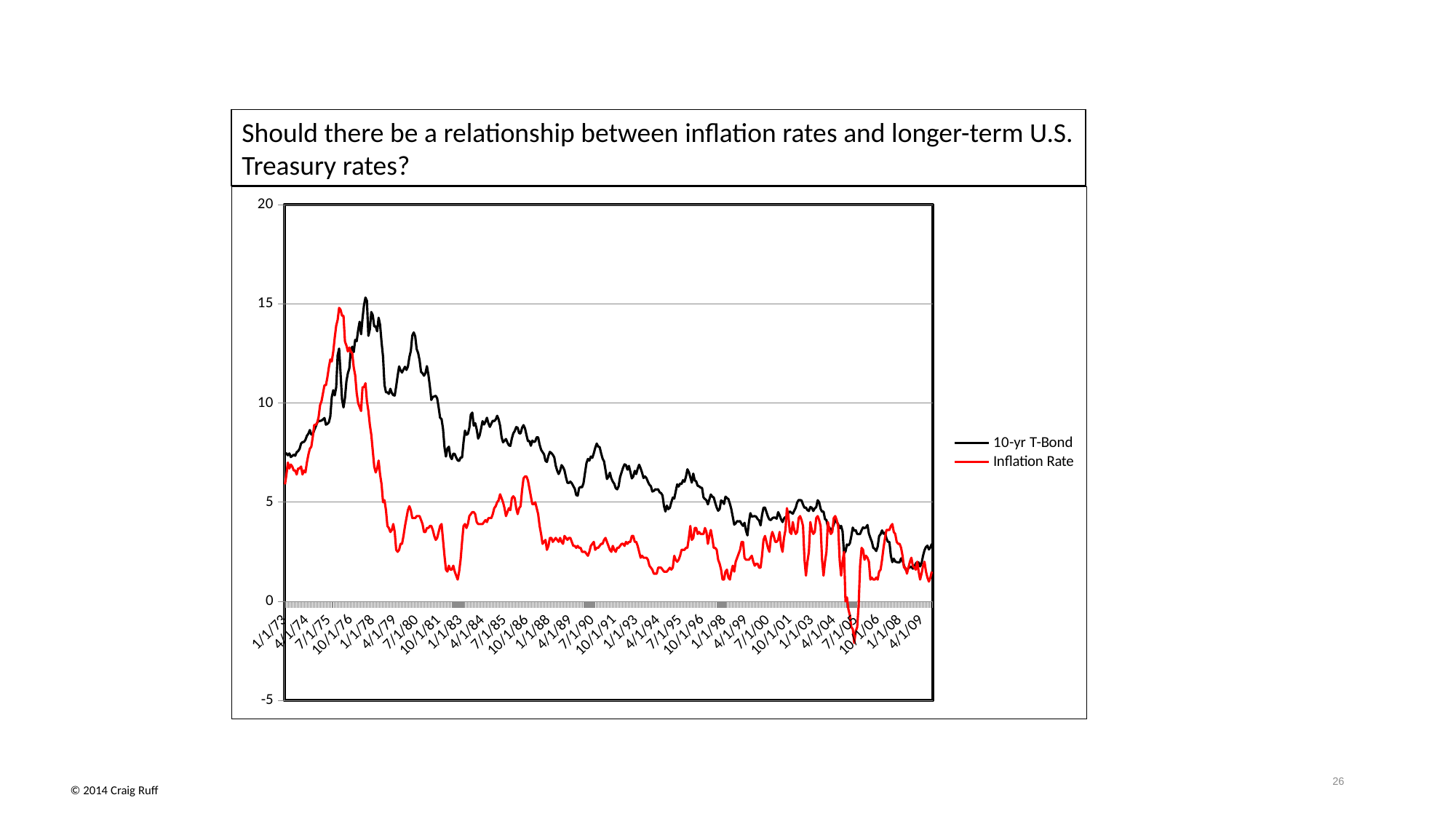
Which series is drawn in black? 10-yr T-Bond Which series is drawn in red? Inflation Rate Around 7/1/90, which series has the higher value, 10-yr T-Bond or Inflation Rate? 10-yr T-Bond What is the highest value shown on the vertical axis? 20 Is the 10-yr T-Bond value at 1/1/73 greater or less than 5? greater Is the Inflation Rate value at 1/1/83 greater or less than 5? less Is the 10-yr T-Bond value at 7/1/90 greater or less than 5? greater What kind of chart is shown on the slide? Line chart What is the lowest value shown on the vertical axis? -5 Does the 10-yr T-Bond series generally rise or fall from the early 1980s to 4/1/09? Fall How many series does the legend list? 2